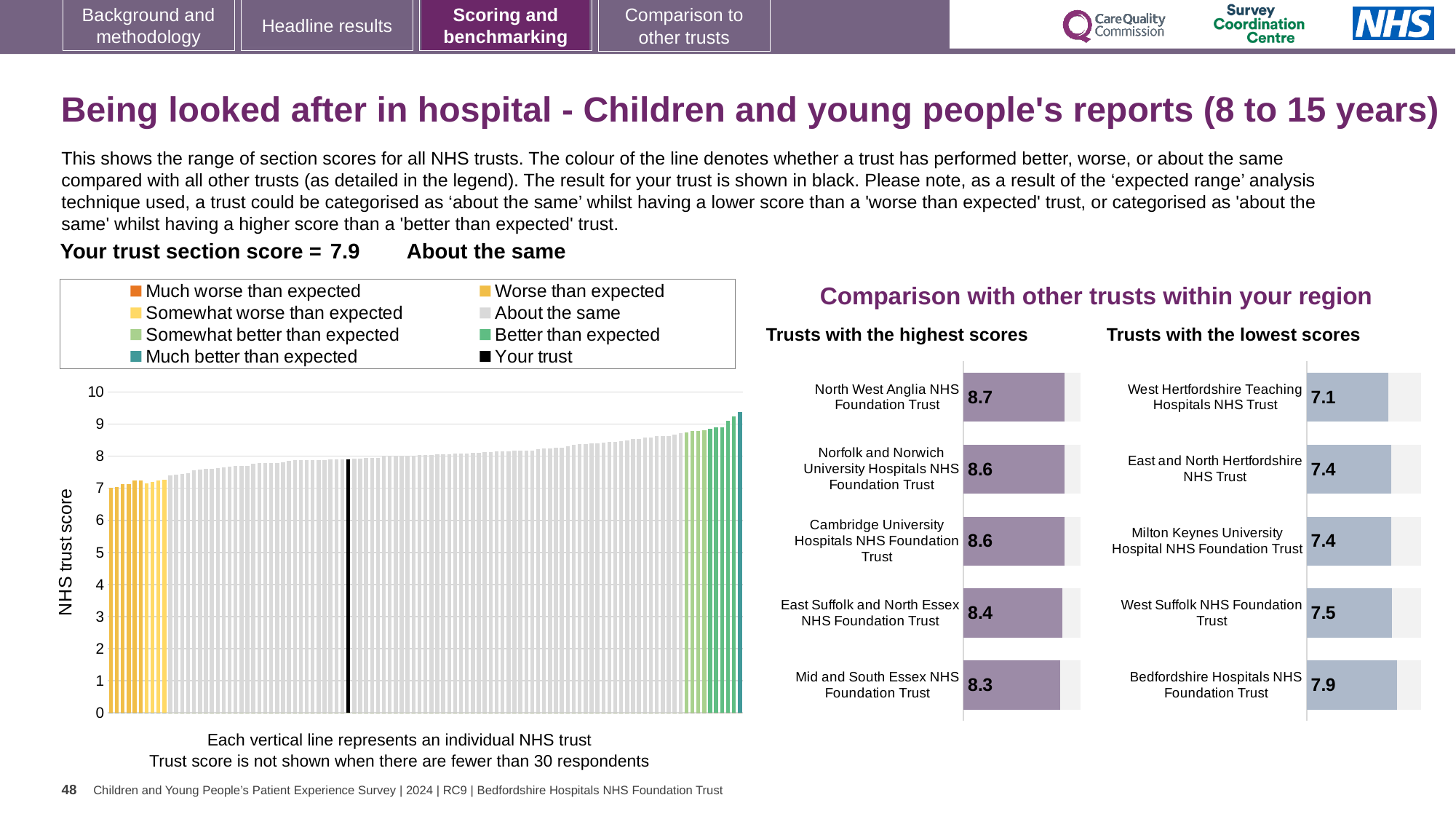
What kind of chart is the main chart on the left showing NHS trust scores? bar chart In the 'Trusts with the highest scores' chart, what is the score for North West Anglia NHS Foundation Trust? 8.7 How many trusts are shown in the 'Trusts with the highest scores' chart? 5 In the main chart on the left, what is the section score for your trust (the black bar)? 7.9 In the 'Trusts with the lowest scores' chart, what is the score for West Hertfordshire Teaching Hospitals NHS Trust? 7.1 In the main chart on the left, do the trust scores rise or fall from left to right? rise In the 'Trusts with the highest scores' chart, what is the difference between the scores of North West Anglia NHS Foundation Trust and Mid and South Essex NHS Foundation Trust? 0.4 In the 'Trusts with the lowest scores' chart, what is the score for Bedfordshire Hospitals NHS Foundation Trust? 7.9 In the 'Trusts with the highest scores' chart, which trust has the highest score? North West Anglia NHS Foundation Trust In the 'Trusts with the lowest scores' chart, which trust has the lowest score? West Hertfordshire Teaching Hospitals NHS Trust In the 'Trusts with the lowest scores' chart, which has the larger score: West Suffolk NHS Foundation Trust or Milton Keynes University Hospital NHS Foundation Trust? West Suffolk NHS Foundation Trust How many entries does the legend of the main chart on the left list? 8